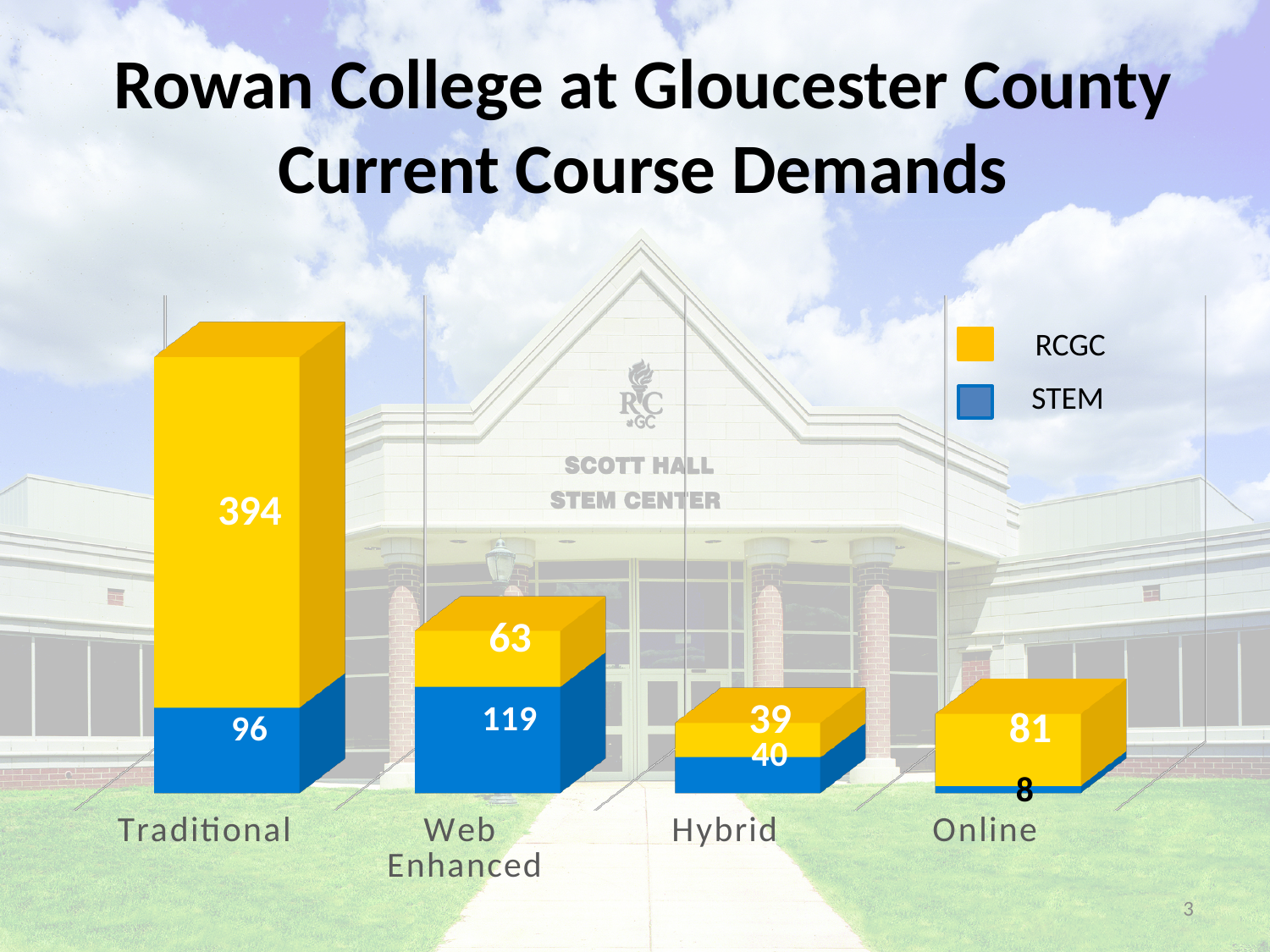
What is the STEM value for Web Enhanced? 119 Which category has the highest RCGC value? Traditional Which category has the lowest STEM value? Online What is the total of the stacked bar for Online? 89 What kind of chart is shown on the slide? Stacked bar chart For Web Enhanced, which is larger, the RCGC value or the STEM value? STEM What is the difference between the RCGC and STEM values for Traditional? 298 What is the STEM value for Online? 8 What is the RCGC value for Hybrid? 39 How many categories are shown on the x axis? 4 How many series does the legend list? 2 What is the RCGC value for Traditional? 394